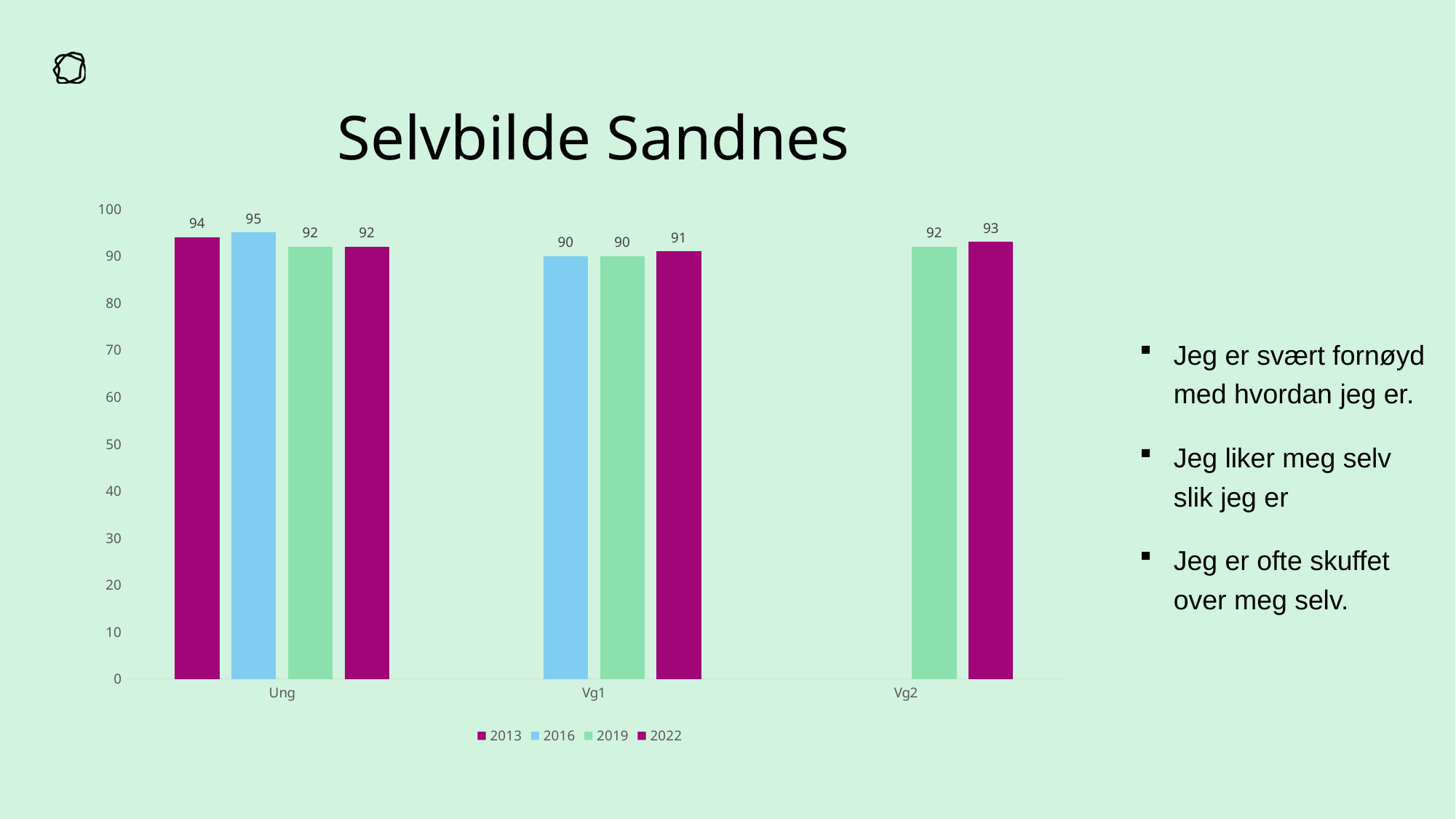
Which category has the highest value for the 2016 series? Ung What is the difference between the 2016 values for Ung and Vg1? 5 What kind of chart is shown on the slide? bar chart What is the value for 2019 in the Vg1 category? 90 Is the 2016 value for Vg1 greater or less than 80? greater Which category has the lowest value for the 2019 series? Vg1 What is the value for 2016 in the Ung category? 95 What is the title of the chart? Selvbilde Sandnes What is the value for 2019 in the Vg2 category? 92 Which is larger: the 2019 value for Ung or the 2019 value for Vg1? Ung How many series does the legend list? 4 How many categories are shown on the x axis? 3